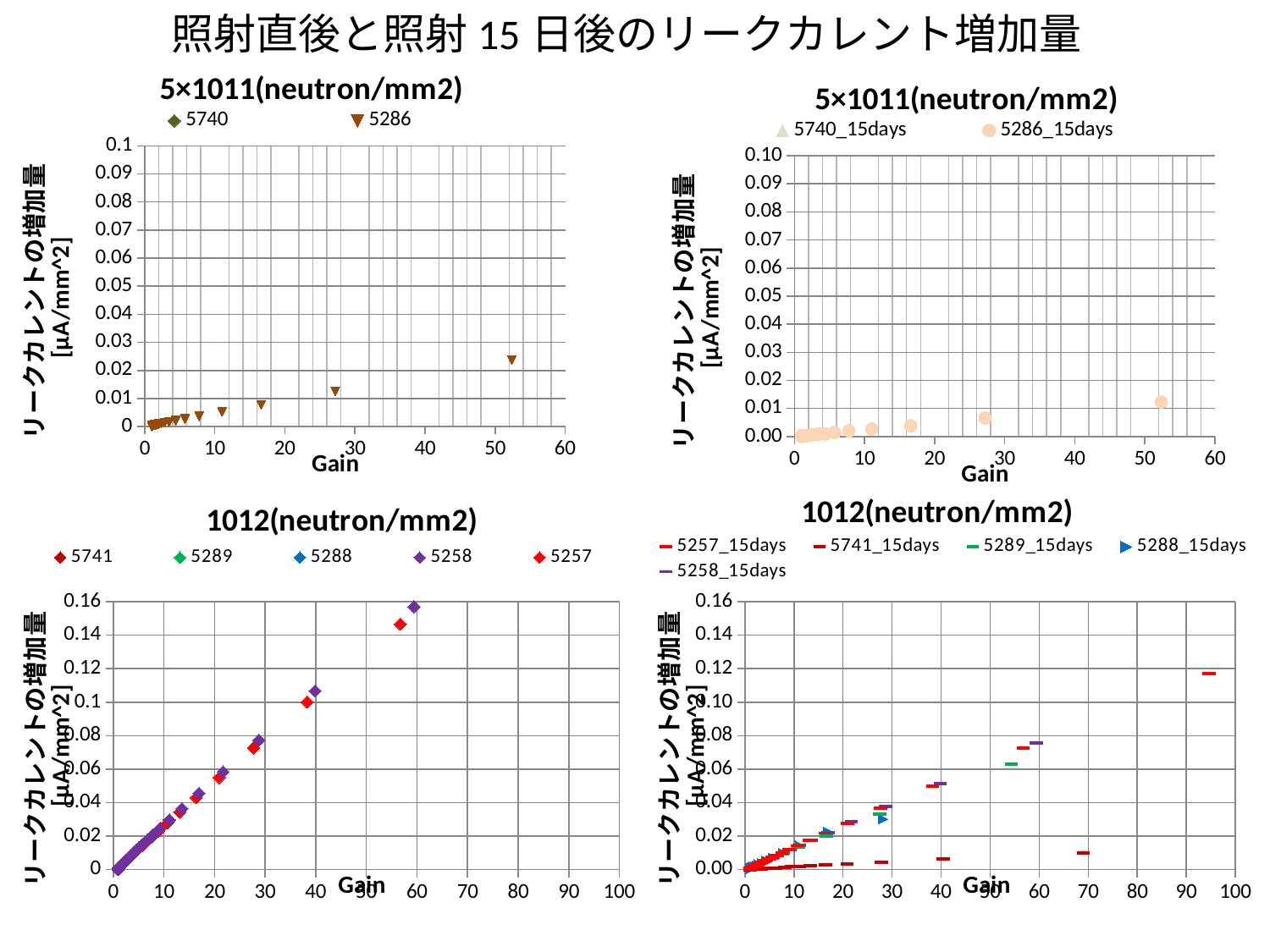
What is the x-axis label of the bottom-left chart titled 1012(neutron/mm2)? Gain What kind of chart is the top-left chart titled 5×1011(neutron/mm2)? scatter chart Which is larger: the value of series 5286 at Gain around 52 in the top-left chart, or the value of series 5286_15days at Gain around 52 in the top-right chart? 5286 in the top-left chart In the top-left chart titled 5×1011(neutron/mm2), is the value of series 5286 at its highest Gain (around 52) greater or less than 0.05? less In the bottom-left chart titled 1012(neutron/mm2), do the plotted values rise or fall as Gain increases? rise How many series does the legend of the bottom-left chart titled 1012(neutron/mm2) list? 5 How many series does the legend of the bottom-right chart (1012(neutron/mm2), 15days series) list? 5 In the top-right chart titled 5×1011(neutron/mm2), is the value of series 5286_15days at its highest Gain (around 52) greater or less than 0.02? less In the bottom-left chart titled 1012(neutron/mm2), is the highest plotted value (at Gain around 59) greater or less than 0.14? greater How many series does the legend of the top-left chart (5×1011(neutron/mm2), with 5740 and 5286) list? 2